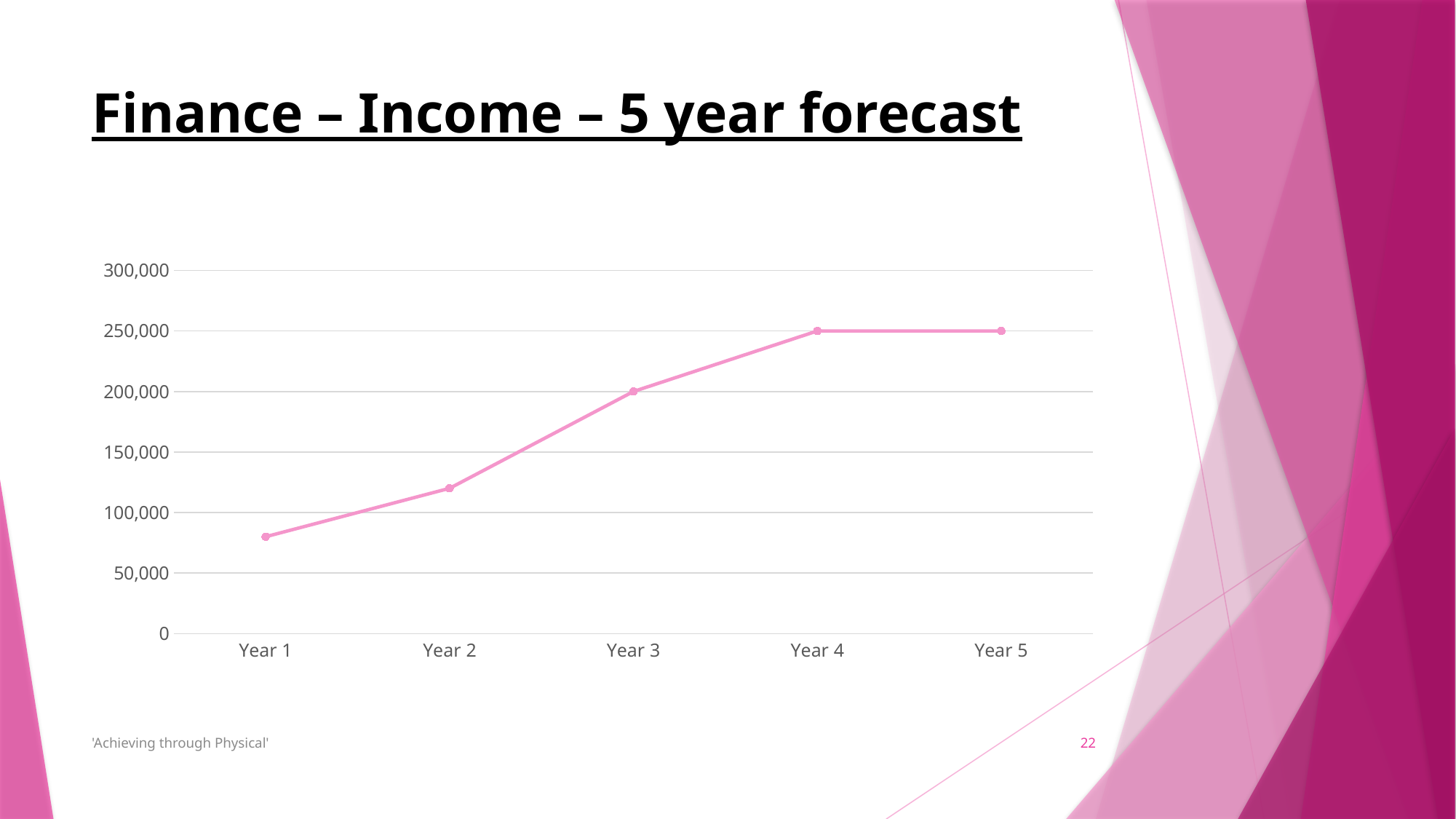
What is the value for Year 4? 250,000 What is the difference between the values for Year 4 and Year 3? 50,000 What is the value for Year 3? 200,000 What kind of chart is shown on the slide? line chart What is the value for Year 5? 250,000 Which is larger, the value for Year 2 or the value for Year 3? Year 3 How many years are plotted on the x axis of the chart? 5 Is the value for Year 2 greater or less than 150,000? less Is the value for Year 1 greater or less than 100,000? less Which year has the lowest value? Year 1 Is the value for Year 2 greater or less than 100,000? greater Do the values generally rise or fall from Year 1 to Year 5? rise